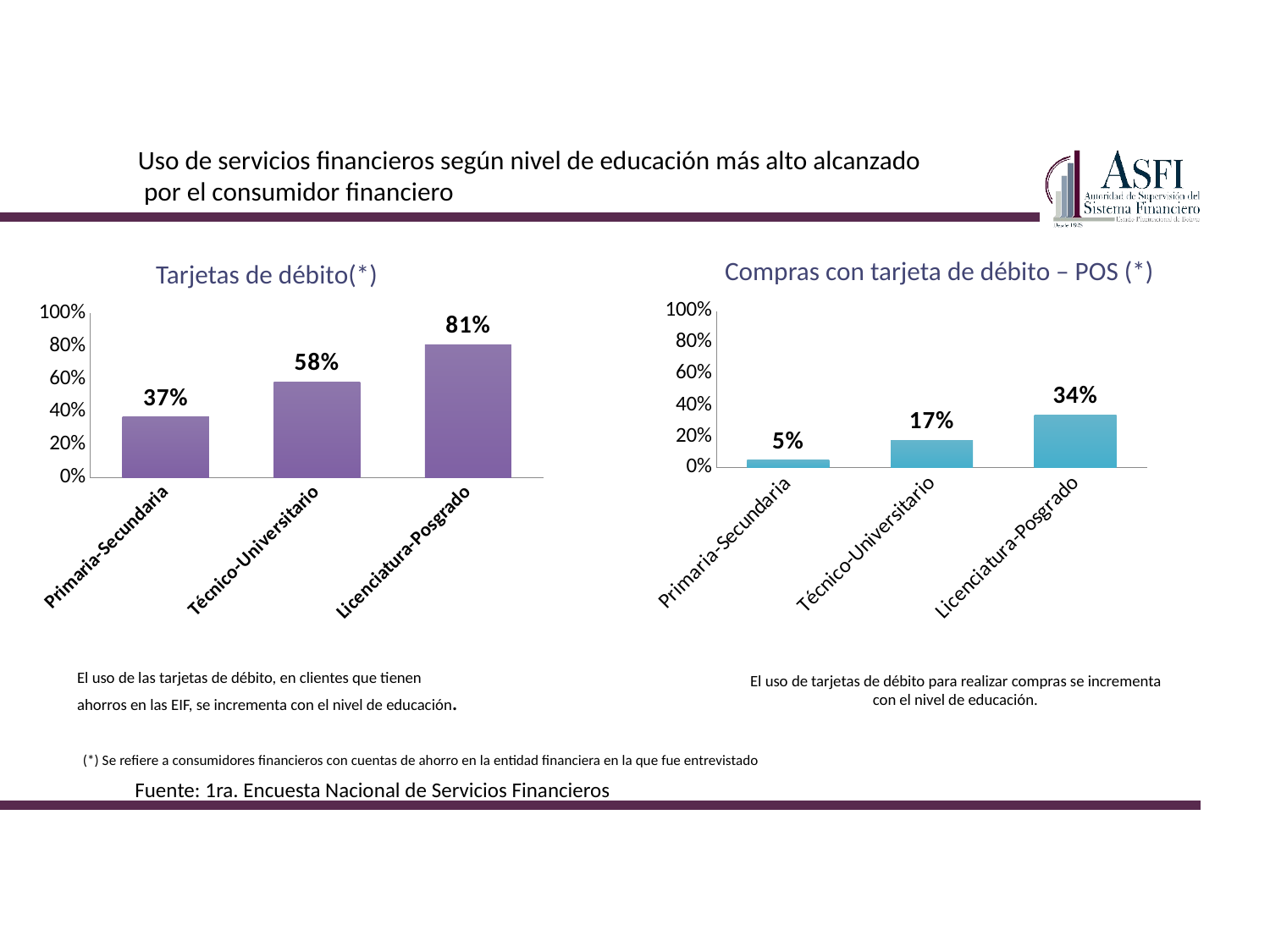
What type of chart is the 'Tarjetas de débito(*)' chart? bar chart In the 'Tarjetas de débito(*)' chart, is the value for Primaria-Secundaria greater or less than 40%? less Which is larger: the Técnico-Universitario value in the 'Tarjetas de débito(*)' chart or the Licenciatura-Posgrado value in the 'Compras con tarjeta de débito – POS (*)' chart? Técnico-Universitario in Tarjetas de débito(*) In the 'Tarjetas de débito(*)' chart, what is the value for Técnico-Universitario? 58% In the 'Compras con tarjeta de débito – POS (*)' chart, do the values rise or fall from Primaria-Secundaria to Licenciatura-Posgrado? rise In the 'Compras con tarjeta de débito – POS (*)' chart, what is the difference between Licenciatura-Posgrado and Técnico-Universitario? 17% What is the title of the chart on the right side of the slide? Compras con tarjeta de débito – POS (*) In the 'Tarjetas de débito(*)' chart, which category has the highest value? Licenciatura-Posgrado In the 'Compras con tarjeta de débito – POS (*)' chart, which category has the lowest value? Primaria-Secundaria In the 'Tarjetas de débito(*)' chart, what is the difference between Licenciatura-Posgrado and Primaria-Secundaria? 44% In the 'Compras con tarjeta de débito – POS (*)' chart, what is the value for Primaria-Secundaria? 5% How many categories are shown in the 'Compras con tarjeta de débito – POS (*)' chart? 3